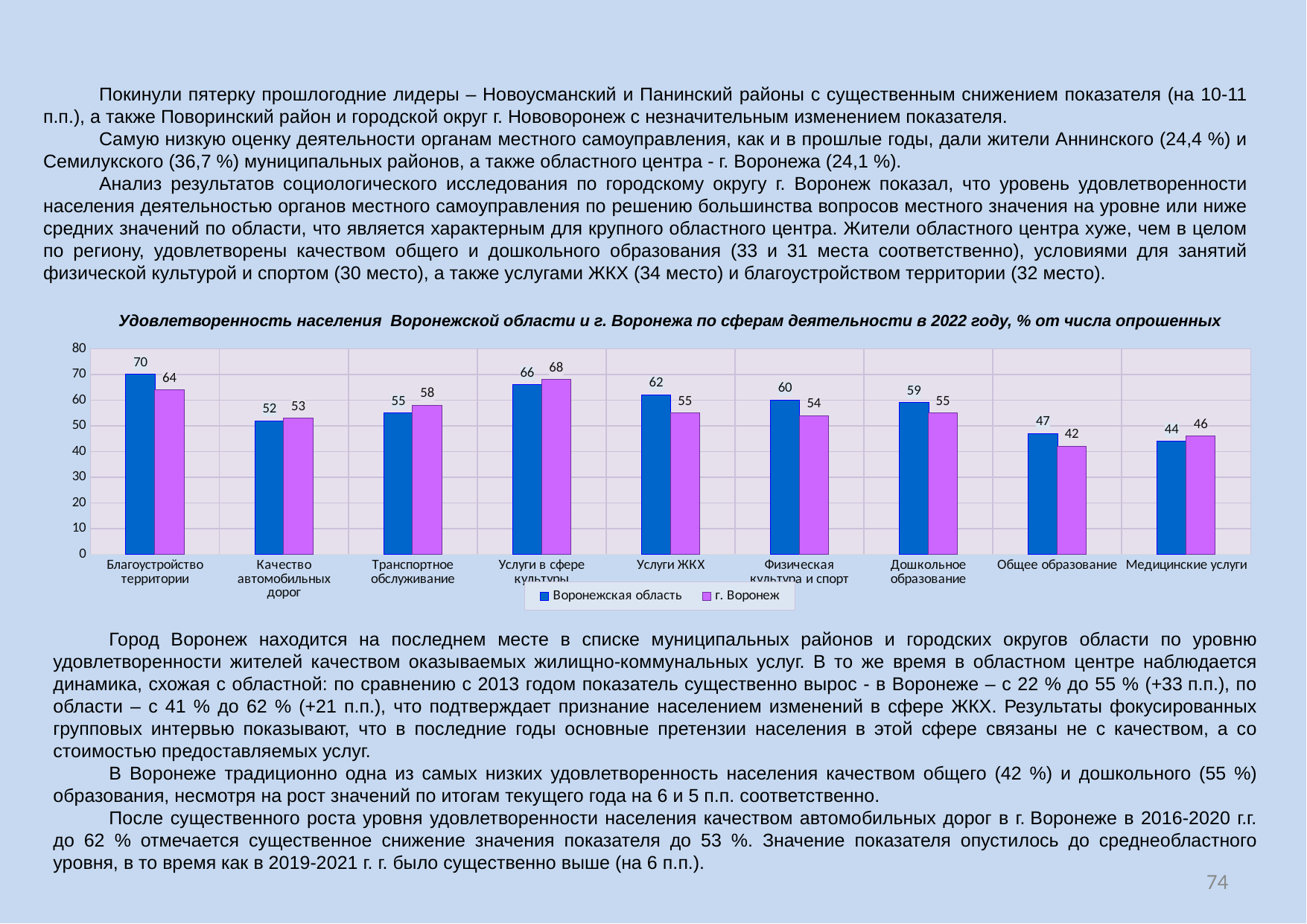
How many series does the chart legend list? 2 What is the value for Воронежская область in the Благоустройство территории category? 70 Which colour represents the г. Воронеж series in the chart? purple Which category has the lowest value for г. Воронеж? Общее образование What is the value for г. Воронеж in the Услуги ЖКХ category? 55 How many categories are shown on the x axis of the chart? 9 Is the value for г. Воронеж in the Медицинские услуги category greater or less than 50? less In the Физическая культура и спорт category, which series has the larger value: Воронежская область or г. Воронеж? Воронежская область Which category has the highest value for Воронежская область? Благоустройство территории What is the difference between the Воронежская область and г. Воронеж values in the Услуги ЖКХ category? 7 What is the value for г. Воронеж in the Общее образование category? 42 What kind of chart is shown on the slide? bar chart